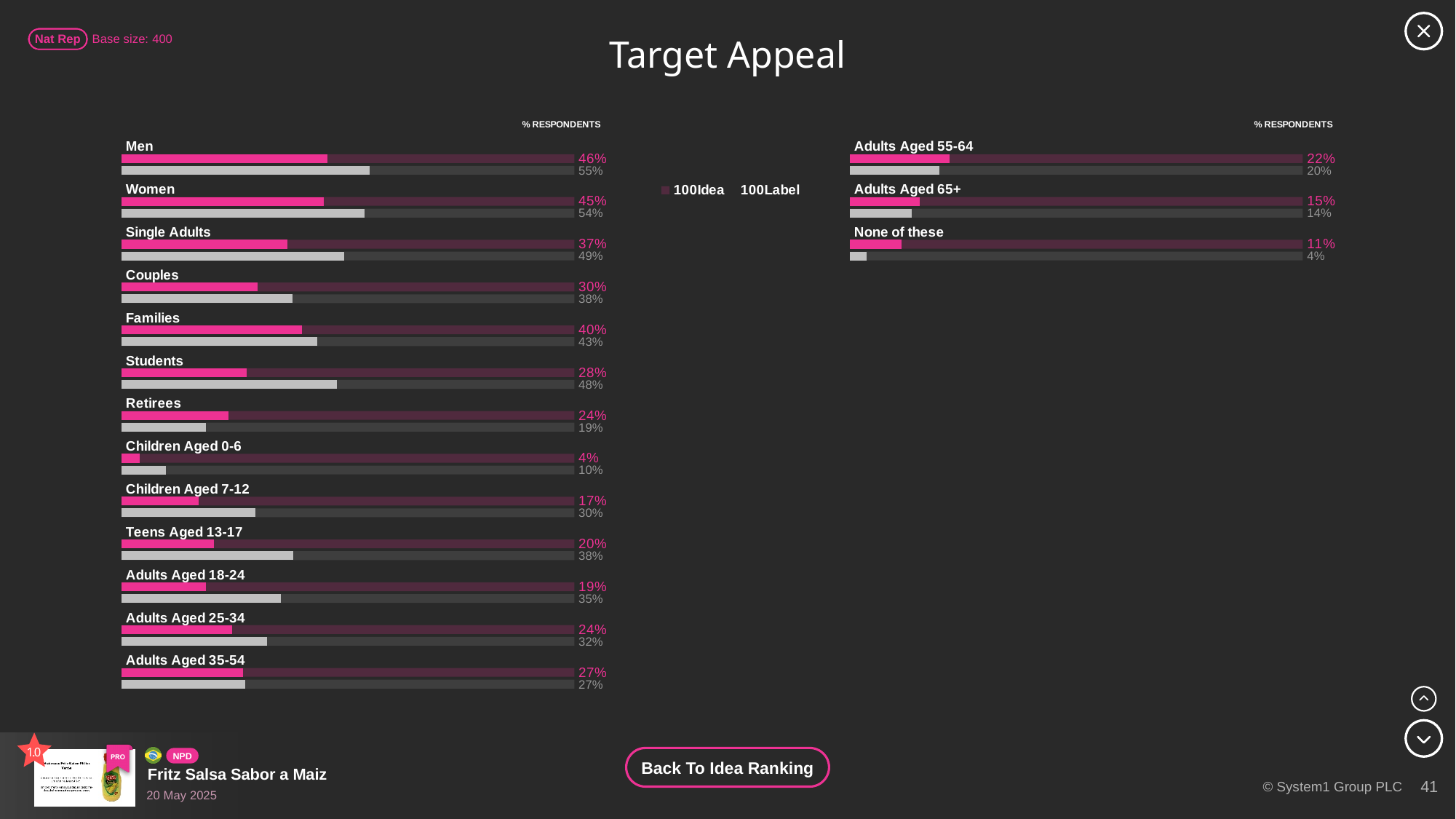
Which category has the highest pink (Idea) value? Men What is the difference between the grey (Label) value and the pink (Idea) value for Single Adults? 12% What is the grey (Label) value for Students? 48% What is the pink (Idea) value for Men? 46% What is the pink (Idea) value for None of these? 11% Which is larger for Retirees, the pink (Idea) value or the grey (Label) value? pink (Idea), 24% How many series does the legend list? 2 Which category has the lowest pink (Idea) value? Children Aged 0-6 What is the title of the slide's chart? Target Appeal What is the difference between the pink (Idea) values for Men and Women? 1% What kind of chart is shown on the slide? bar chart How many categories are shown on the slide in total? 16